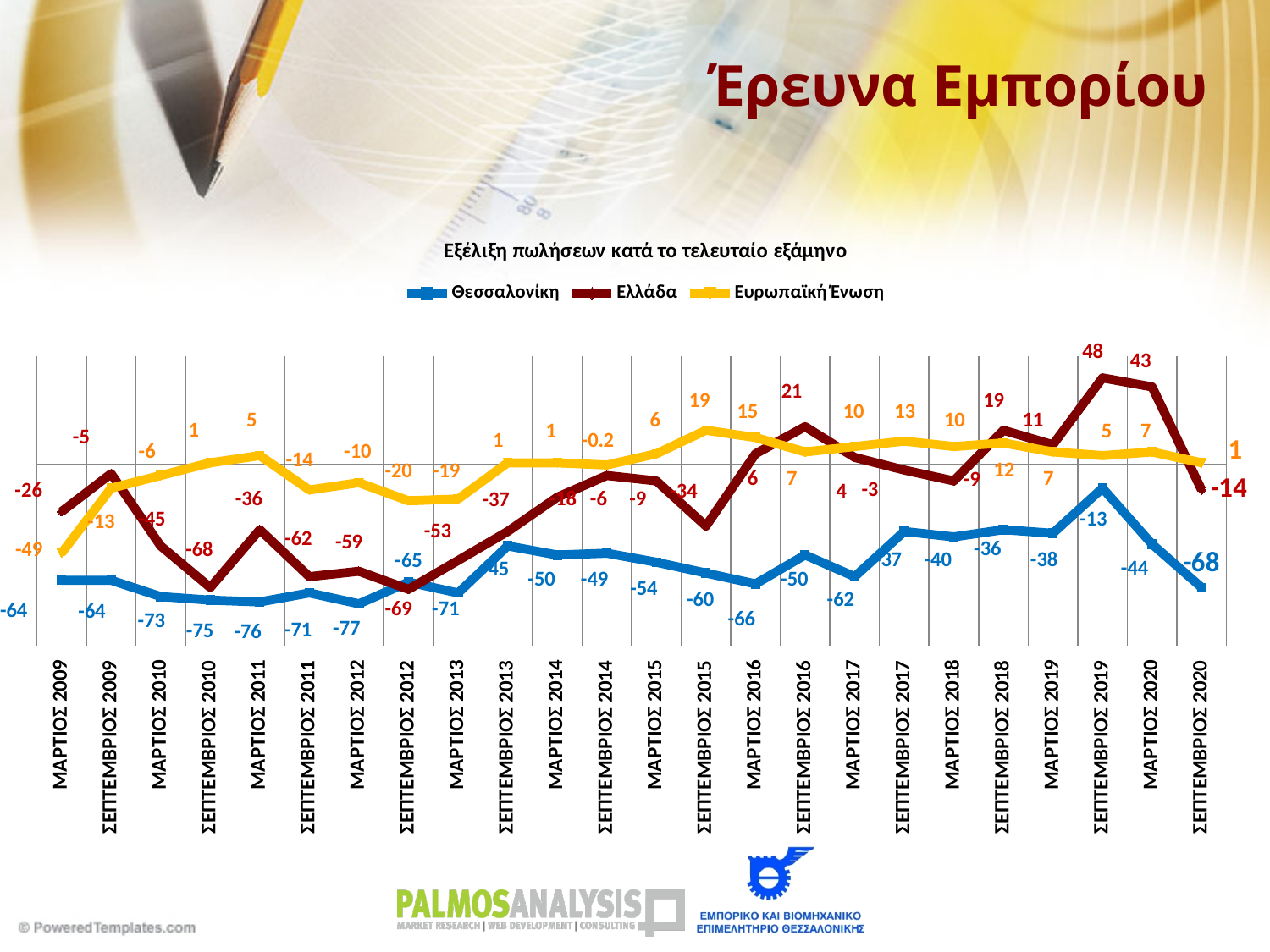
Does the Θεσσαλονίκη series rise or fall from ΣΕΠΤΕΜΒΡΙΟΣ 2019 to ΣΕΠΤΕΜΒΡΙΟΣ 2020? Fall In ΣΕΠΤΕΜΒΡΙΟΣ 2020, which series has the larger value, Ελλάδα or Θεσσαλονίκη? Ελλάδα How many time points are shown on the x axis? 24 What is the value for Θεσσαλονίκη in ΣΕΠΤΕΜΒΡΙΟΣ 2020? -68 In which period does the Θεσσαλονίκη series reach its lowest value? ΜΑΡΤΙΟΣ 2012 What kind of chart is shown on the slide? Line chart What is the value for Ελλάδα in ΣΕΠΤΕΜΒΡΙΟΣ 2019? 48 How many series does the legend list? 3 What is the value for Ευρωπαϊκή Ένωση in ΜΑΡΤΙΟΣ 2009? -49 In which period does the Ελλάδα series reach its highest value? ΣΕΠΤΕΜΒΡΙΟΣ 2019 What colour is the line for Ελλάδα? Dark red What is the difference between the Ελλάδα values in ΣΕΠΤΕΜΒΡΙΟΣ 2019 and ΜΑΡΤΙΟΣ 2020? 5